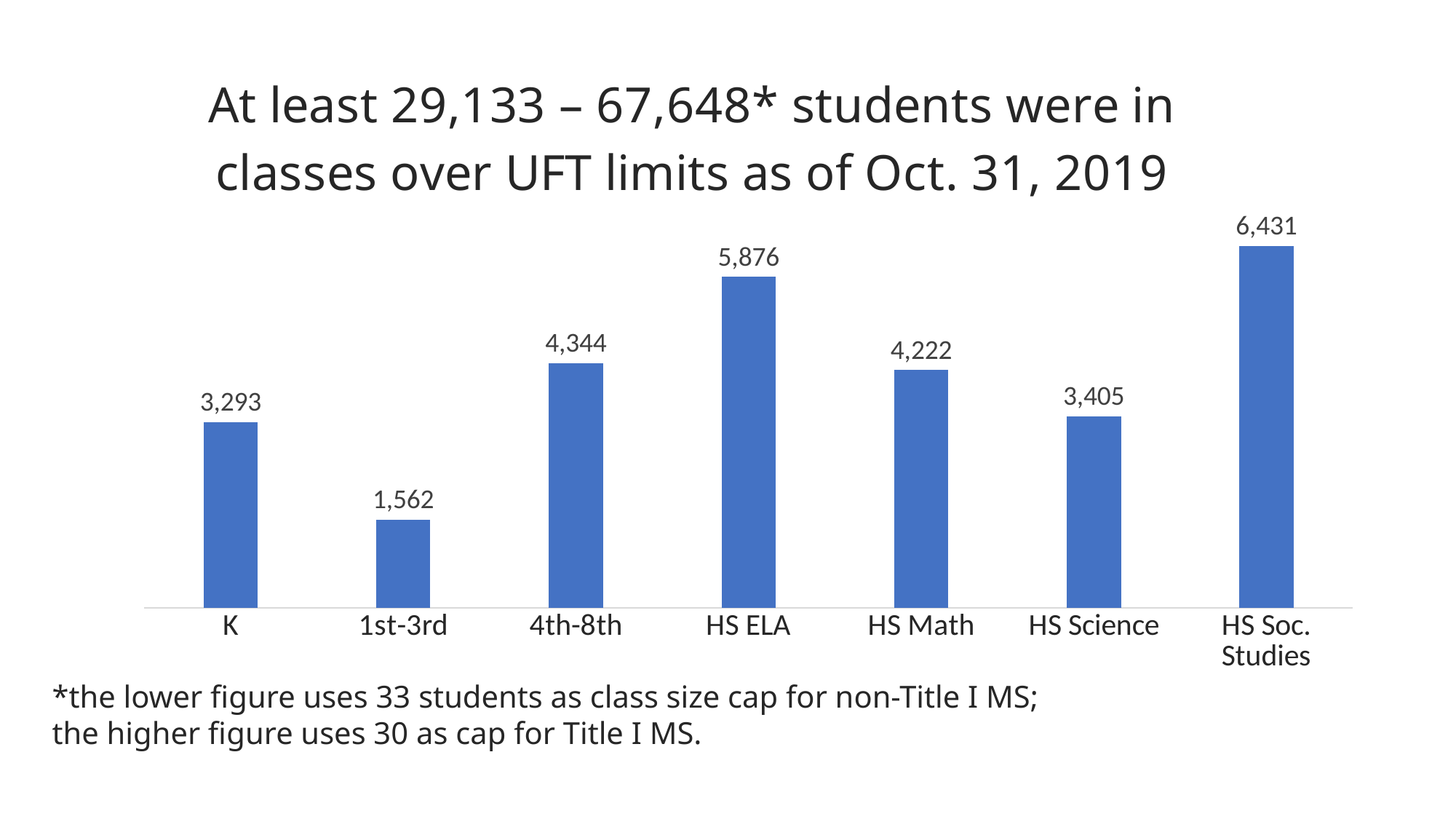
What kind of chart is this? Bar chart What is the title of the chart? At least 29,133 – 67,648* students were in classes over UFT limits as of Oct. 31, 2019 Which category has the highest value? HS Soc. Studies What is the value for HS ELA? 5,876 How many categories are shown on the x axis? 7 What is the value for K? 3,293 What is the value for HS Science? 3,405 What is the difference between the values for 4th-8th and HS Math? 122 Which is larger, the value for K or the value for HS Science? HS Science What is the value for 1st-3rd? 1,562 What is the difference between the values for HS Soc. Studies and HS ELA? 555 Which category has the lowest value? 1st-3rd